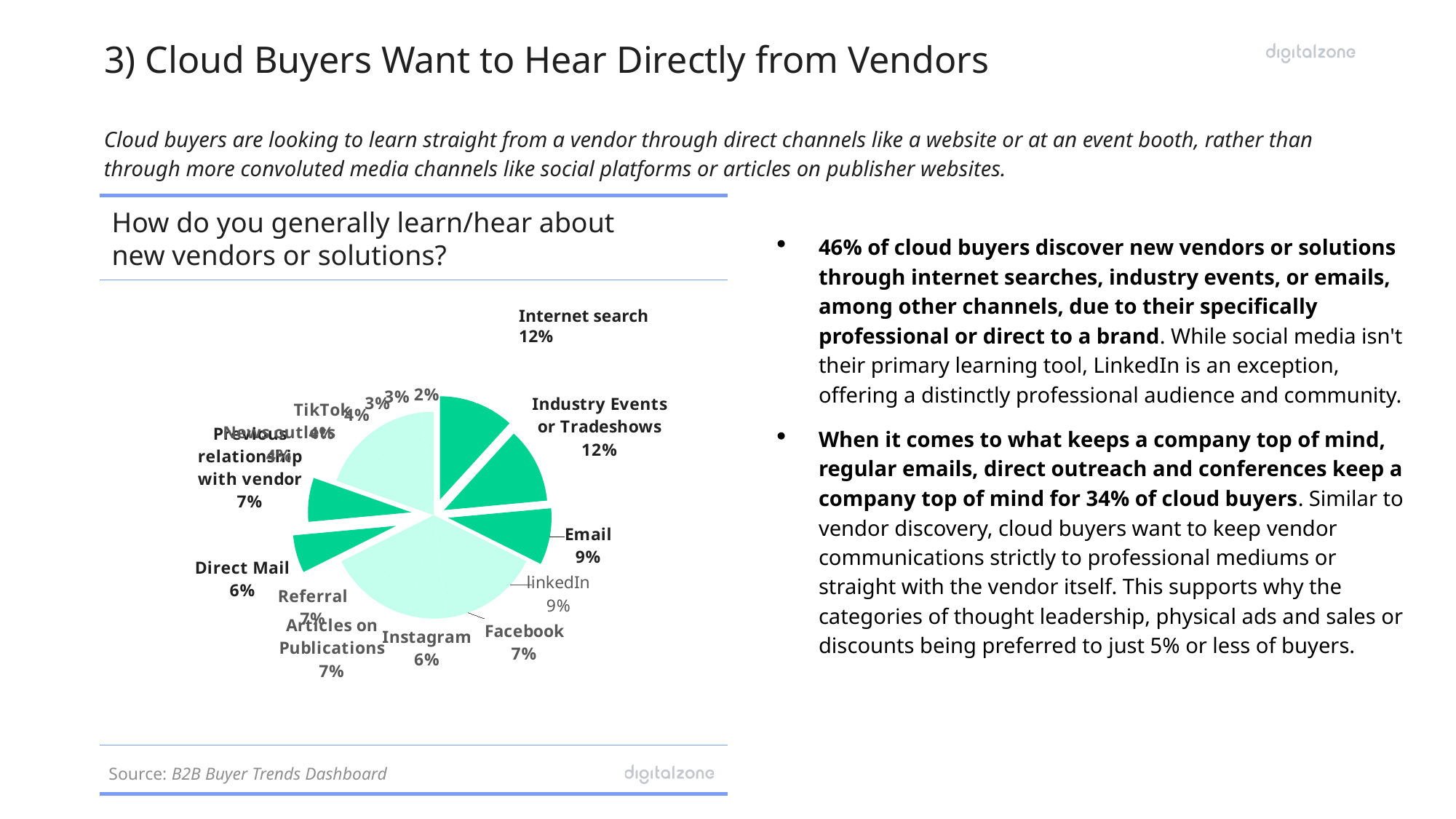
Which is larger, the Industry Events or Tradeshows slice or the Direct Mail slice? Industry Events or Tradeshows What percentage of the pie chart is attributed to Email? 9% What share of the pie chart is Direct Mail? 6% Which slice is larger, Email or Facebook? Email What type of chart is used on the slide? Pie chart What is the title of the chart on the slide? How do you generally learn/hear about new vendors or solutions? What share of respondents learn about new vendors or solutions through Internet search? 12% What percentage is shown for Industry Events or Tradeshows in the pie chart? 12% What share does LinkedIn have in the pie chart? 9% How many percentage points larger is the Internet search slice than the Instagram slice? 6 percentage points What percentage is shown for Facebook? 7% What percentage is shown for Instagram? 6%